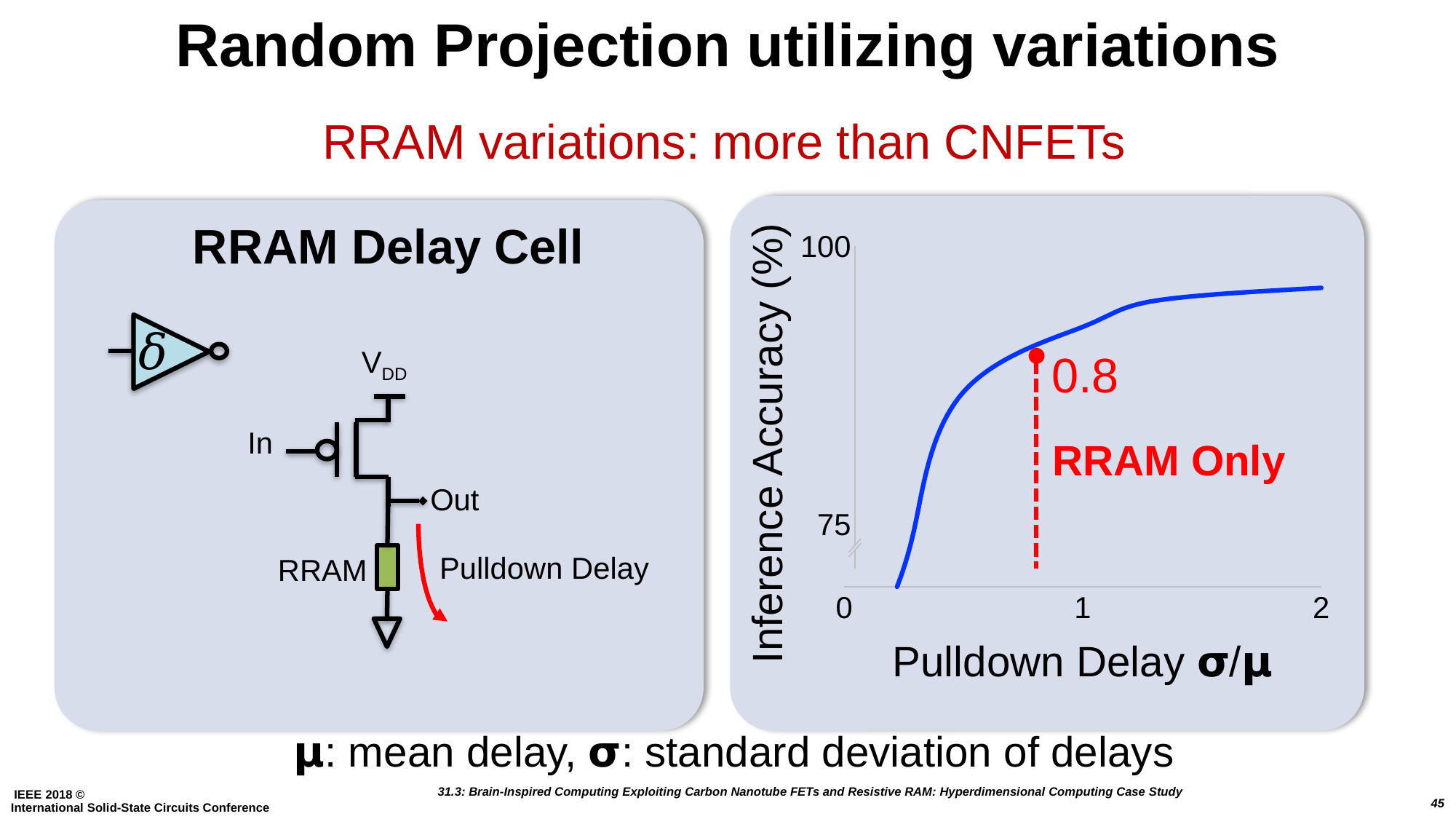
Does inference accuracy rise or fall as Pulldown Delay σ/μ increases along the x axis? rise How many lines (data series) are plotted in the chart? 1 What is the largest tick value shown on the x axis of the chart? 2 What kind of chart is shown on the right side of the slide? line chart At what Pulldown Delay σ/μ value is the red marked point labelled 'RRAM Only' placed? 0.8 Which has higher inference accuracy: Pulldown Delay σ/μ = 0.8 or σ/μ = 2? σ/μ = 2 Is the inference accuracy at Pulldown Delay σ/μ = 2 greater or less than 75? greater What is the label of the y axis of the chart? Inference Accuracy (%) Is the inference accuracy at the 'RRAM Only' point (σ/μ = 0.8) greater or less than 100? less What is the highest tick value shown on the y axis of the chart? 100 What is the label of the x axis of the chart? Pulldown Delay σ/μ Is the inference accuracy at the 'RRAM Only' point (σ/μ = 0.8) greater or less than 75? greater